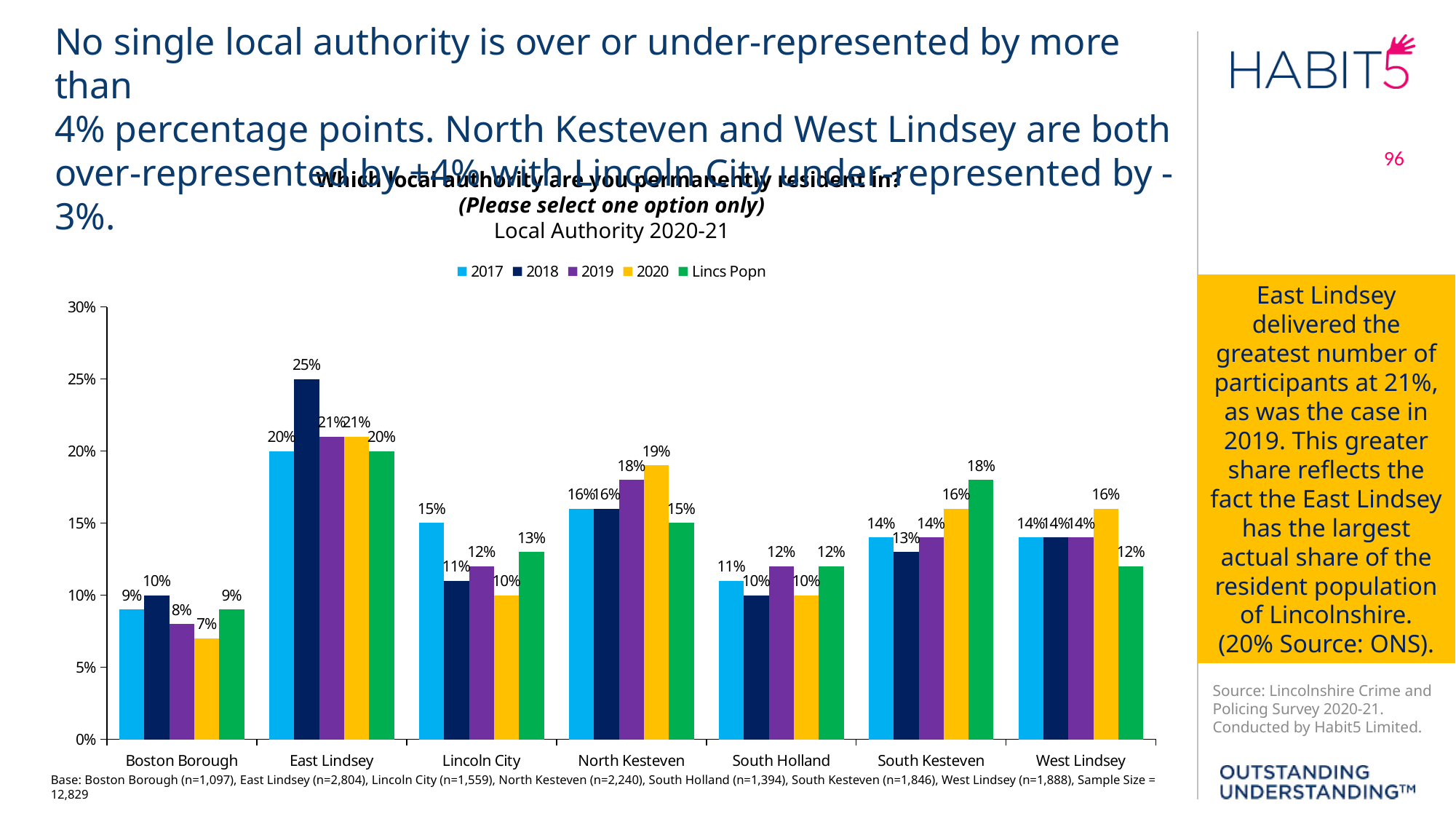
What is the Lincs Popn value for South Kesteven? 18% What is the 2018 value for East Lindsey? 25% How many series does the legend list? 5 Which series is shown in green in the legend? Lincs Popn What type of chart is shown on the slide? bar chart Which local authority has the highest 2020 value? East Lindsey What is the 2020 value for Boston Borough? 7% Which local authority has the lowest 2019 value? Boston Borough What is the difference between the 2020 value and the Lincs Popn value for Lincoln City? 3% Do the values for South Kesteven rise or fall from 2019 to 2020? rise How many local authorities are shown on the x axis? 7 Which is larger for North Kesteven, the 2020 value or the Lincs Popn value? 2020